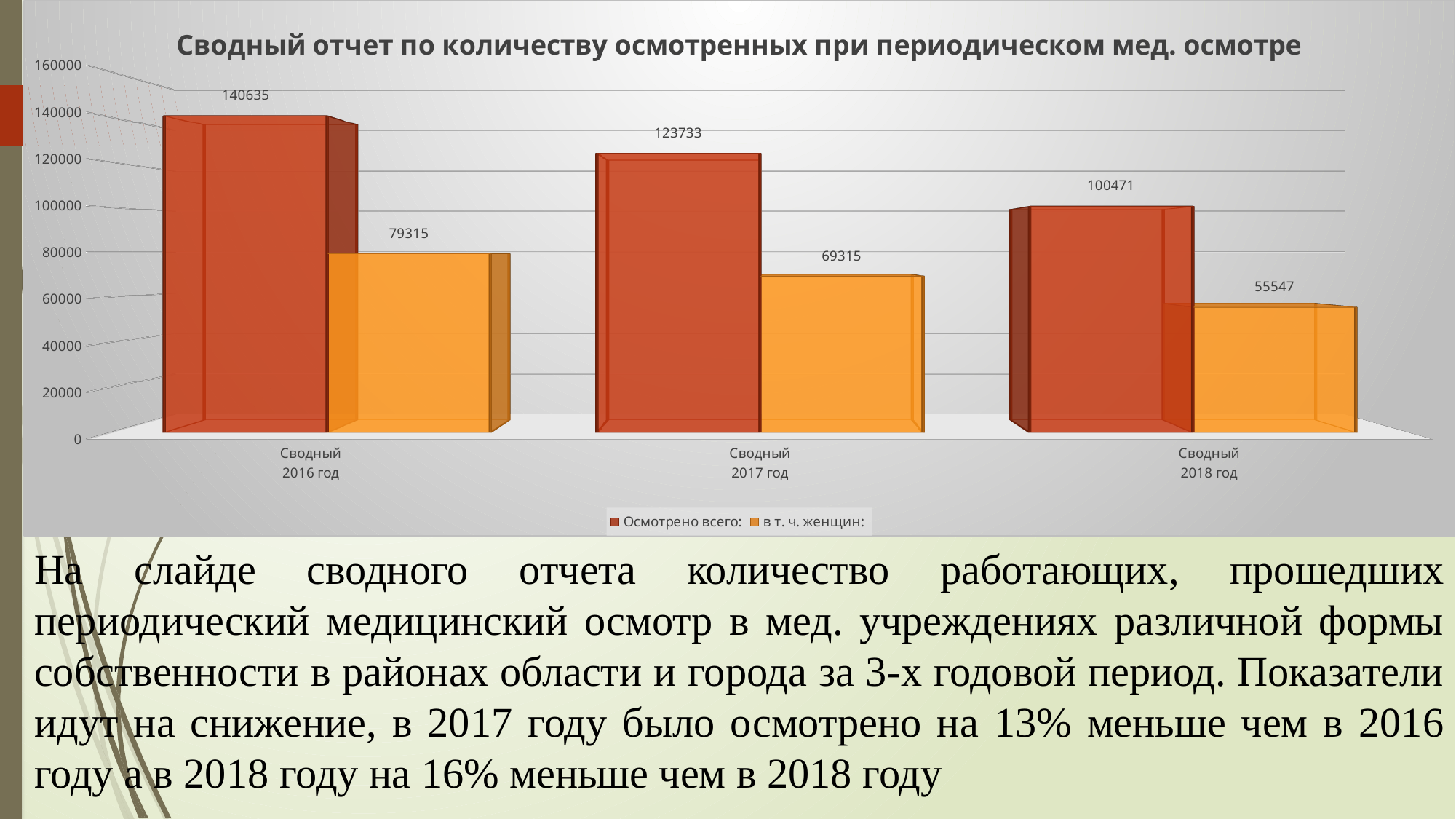
What is the value of "Осмотрено всего:" for "Сводный 2016 год"? 140635 What kind of chart is shown on the slide? Bar chart Do the values for "Осмотрено всего:" rise or fall from 2016 to 2018? Fall How many categories are shown on the x axis? 3 What is the difference between "в т. ч. женщин:" for "Сводный 2016 год" and "Сводный 2017 год"? 10000 Which category has the lowest value for "в т. ч. женщин:"? Сводный 2018 год What is the difference between "Осмотрено всего:" for "Сводный 2016 год" and "Сводный 2017 год"? 16902 Which is larger: "Осмотрено всего:" for "Сводный 2018 год" or "в т. ч. женщин:" for "Сводный 2016 год"? Осмотрено всего: for Сводный 2018 год What is the value of "в т. ч. женщин:" for "Сводный 2017 год"? 69315 How many series does the legend list? 2 What is the value of "в т. ч. женщин:" for "Сводный 2018 год"? 55547 Which category has the highest value for "Осмотрено всего:"? Сводный 2016 год